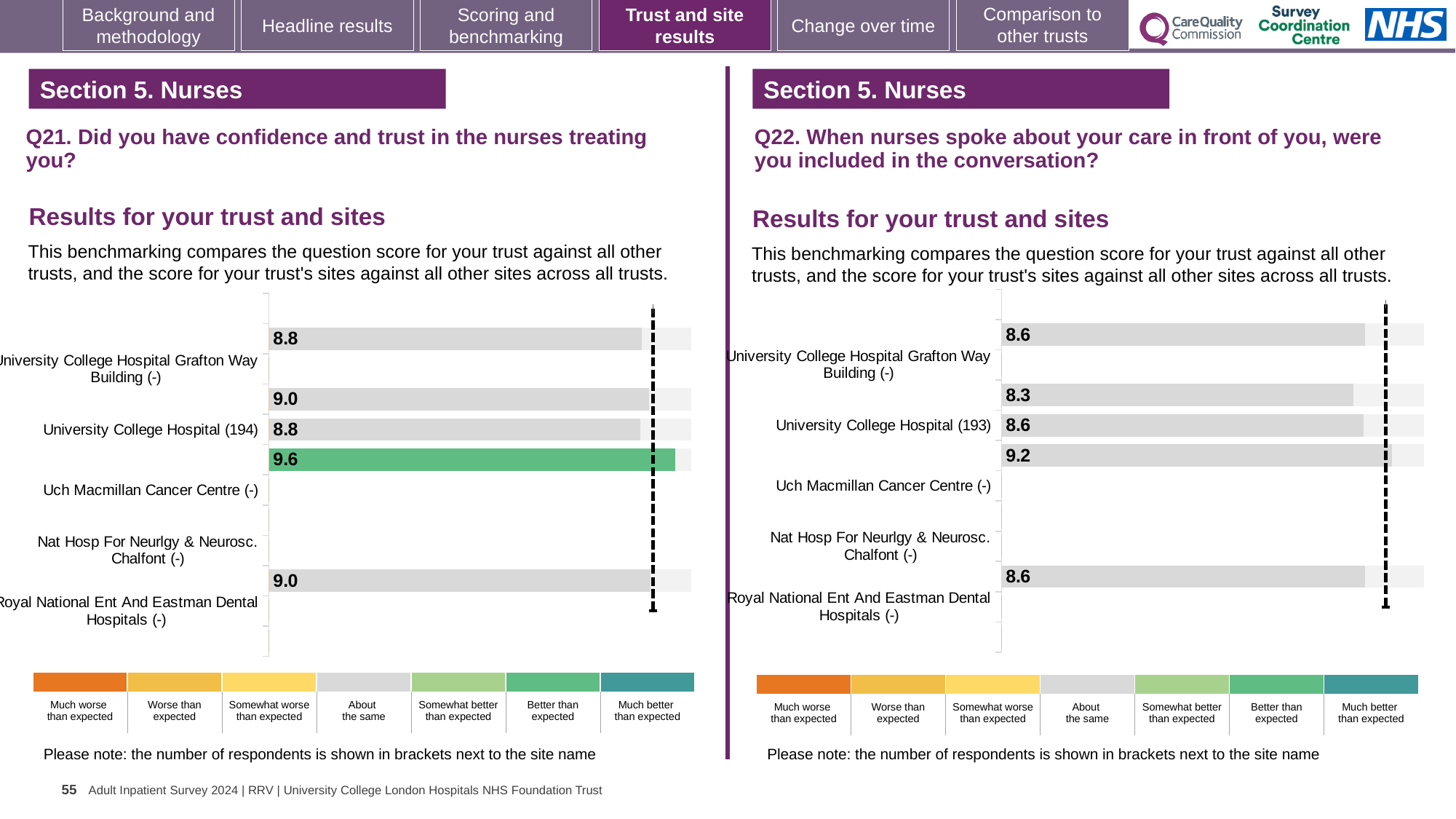
In the Q21 chart on the left, what is the value of the bar aligned with University College Hospital (194)? 8.8 In the Q22 chart on the right, what is the value of the bar aligned with University College Hospital (193)? 8.6 In the Q22 chart on the right, what is the highest value shown on any bar? 9.2 In the Q21 chart on the left, what is the lowest value shown on any bar? 8.8 In the Q21 chart on the left, what is the difference between the highest bar value (9.6) and the lowest bar value (8.8)? 0.8 How many bars with data labels are plotted in the Q21 chart on the left? 5 How many categories does the colour key below each chart list, from 'Much worse than expected' to 'Much better than expected'? 7 In the Q22 chart on the right, what is the difference between the highest bar value (9.2) and the lowest bar value (8.3)? 0.9 In the Q22 chart on the right, what is the lowest value shown on any bar? 8.3 What kind of chart is shown under Q21 on the left side of the slide? bar chart In the Q21 chart on the left, what is the highest value shown on any bar? 9.6 In the Q21 chart on the left, what is the value of the green bar? 9.6